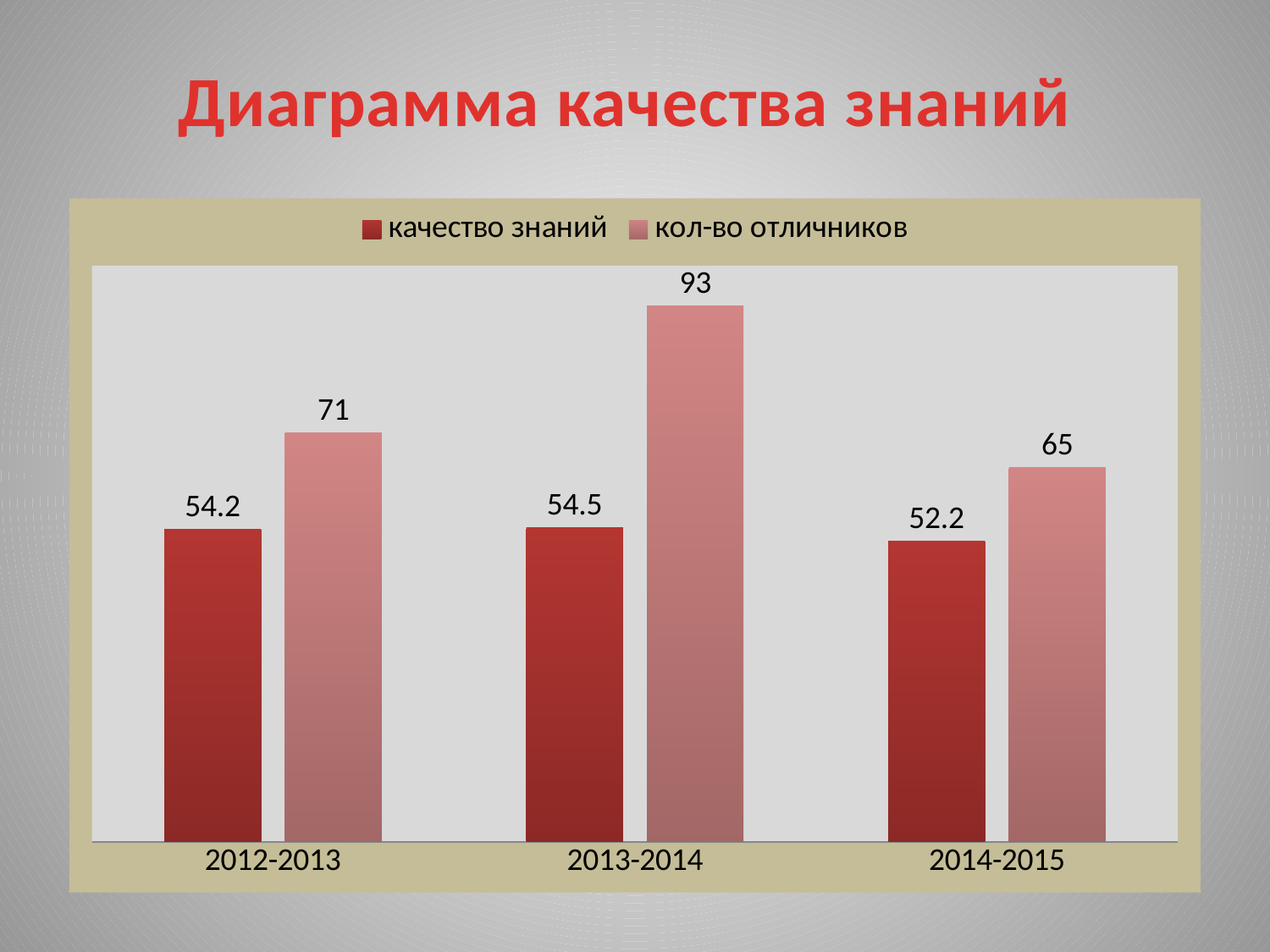
Which is larger: "кол-во отличников" in 2012-2013 or in 2014-2015? 2012-2013 What kind of chart is shown on the slide? bar chart What is the value of "качество знаний" for 2014-2015? 52.2 Which year has the highest value for "кол-во отличников"? 2013-2014 What is the value of "качество знаний" for 2012-2013? 54.2 How many series does the legend list? 2 Which year has the lowest value for "качество знаний"? 2014-2015 How many year categories are shown on the x axis? 3 What is the value of "кол-во отличников" for 2013-2014? 93 What is the value of "кол-во отличников" for 2014-2015? 65 What is the difference between "кол-во отличников" in 2013-2014 and in 2012-2013? 22 What is the title of the slide? Диаграмма качества знаний